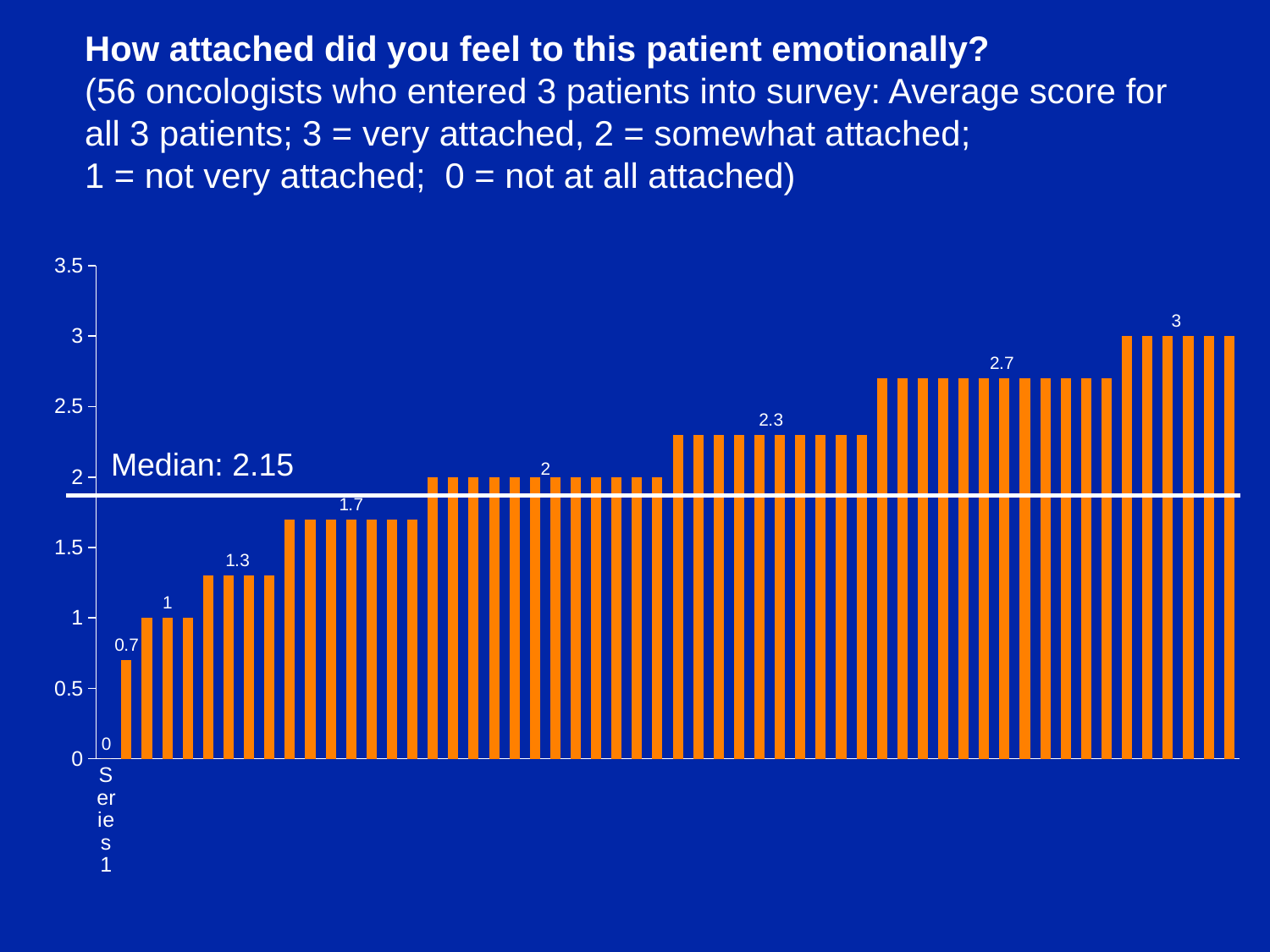
What kind of chart is shown on the slide? bar chart What is the value of the leftmost bar in the chart? 0 What is the highest average attachment score shown in the chart? 3 What is the value of the rightmost bar in the chart? 3 What is the highest value shown on the vertical axis of the chart? 3.5 Do the bar values rise or fall from left to right across the chart? rise What median value is marked on the chart? 2.15 What is the lowest average attachment score shown in the chart? 0 Which is larger, the leftmost bar or the rightmost bar? the rightmost bar What is the difference between the highest bar value and the lowest bar value in the chart? 3 What is the value of the second bar from the left in the chart? 0.7